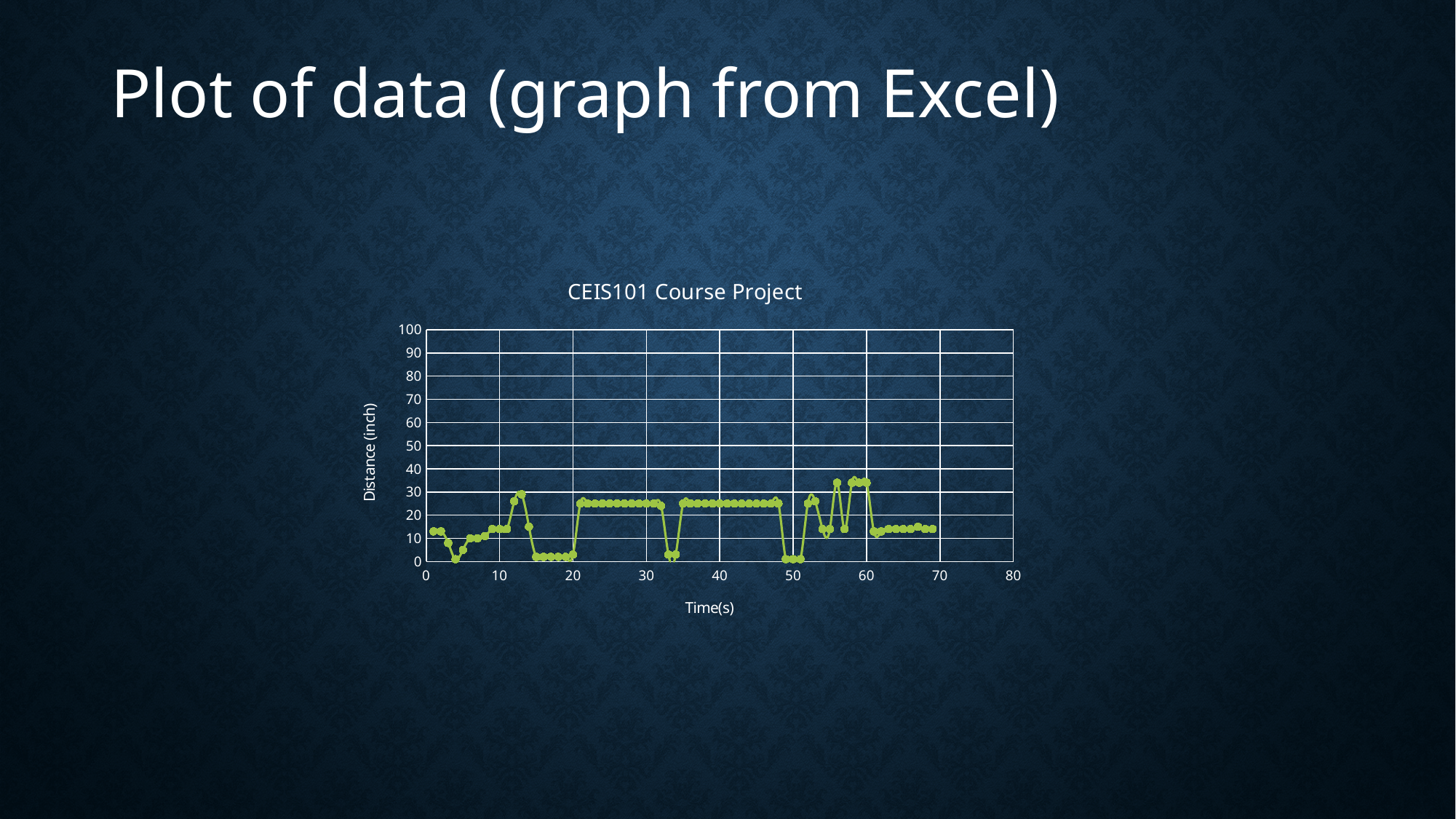
Does the value rise or fall between time 20 and time 21? rise What kind of chart is shown on the slide? line chart What is the title of the chart? CEIS101 Course Project Which is larger, the value at time 25 or the value at time 50? time 25 Is the value at time 65 greater or less than 10? greater Is the value at time 58 greater or less than 30? greater Is the value at time 25 greater or less than 20? greater What is the label of the vertical axis of the chart? Distance (inch)